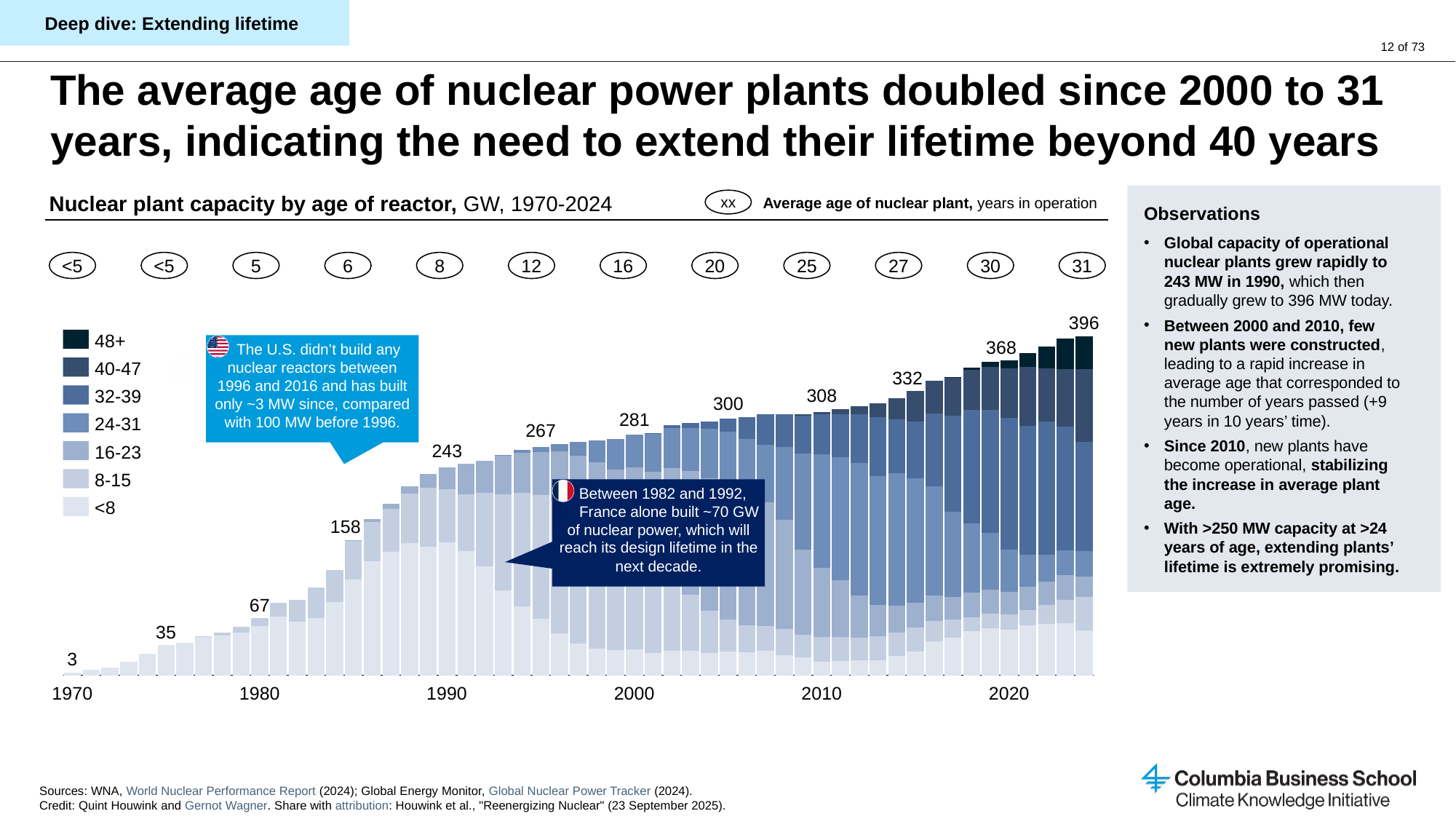
What is the total nuclear plant capacity labelled for 1990? 243 Which labelled year has the lowest total capacity? 1970 What kind of chart is shown on the slide? Stacked bar chart What is the title of the chart? Nuclear plant capacity by age of reactor, GW, 1970-2024 Does total capacity rise or fall from 1970 to 2024? Rise What is the total nuclear plant capacity labelled for 1980? 67 Which is larger, the labelled total capacity in 1985 or in 1995? 1995 How many age-group series does the chart legend list? 7 What is the total nuclear plant capacity labelled for 2024? 396 What is the difference between the labelled total capacity in 2020 and in 2010? 60 Which labelled year has the highest total capacity? 2024 What is the average age of nuclear plants shown in the oval above the 2024 bar? 31